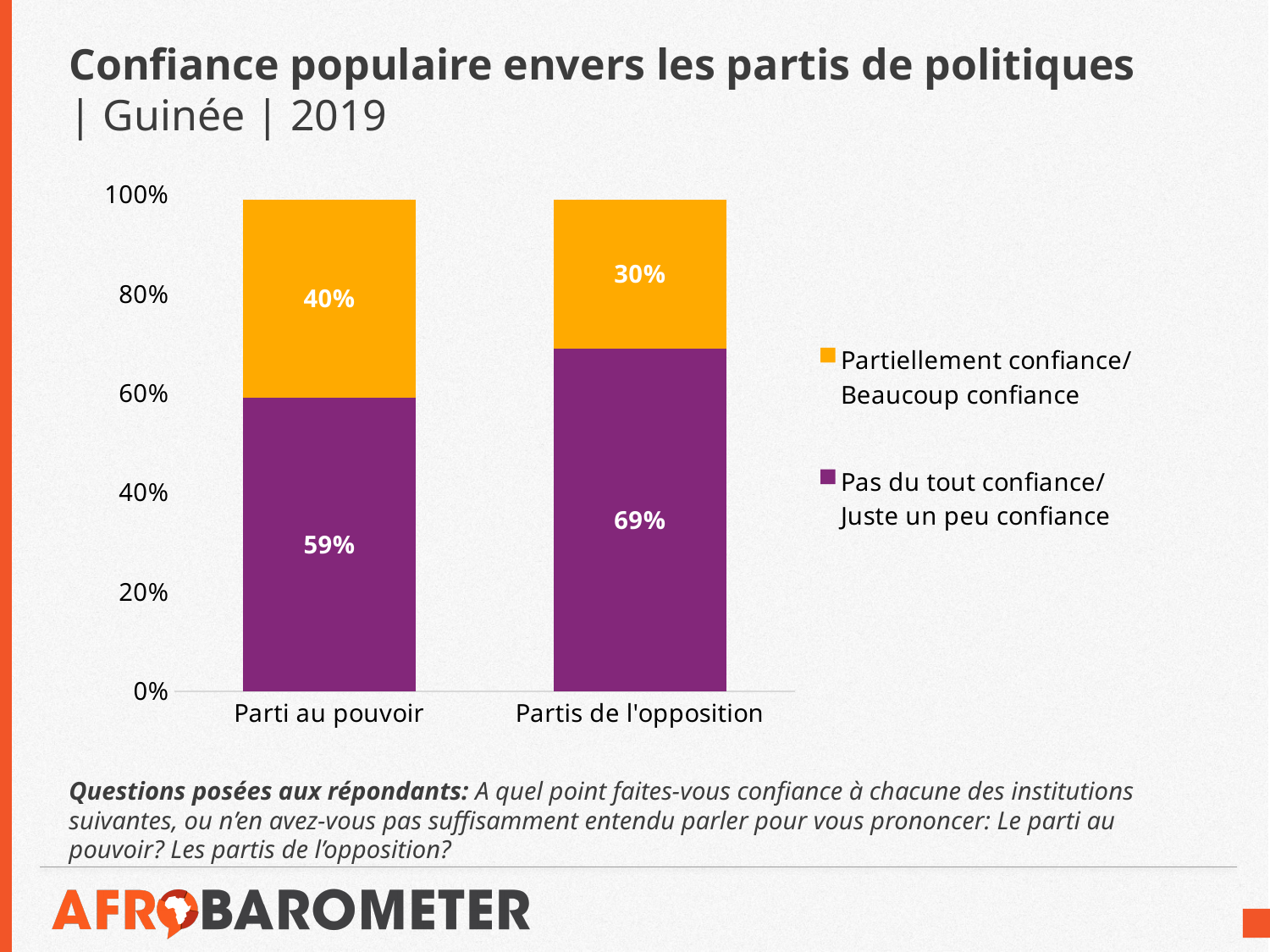
How many categories are shown on the x axis? 2 What is the value for 'Pas du tout confiance/Juste un peu confiance' for the Partis de l'opposition? 69% What is the difference between the 'Pas du tout confiance/Juste un peu confiance' values for Partis de l'opposition and Parti au pouvoir? 10 percentage points What is the total of the stacked bar for the Parti au pouvoir? 99% What kind of chart is shown on the slide? Stacked bar chart Which category has the higher value for 'Pas du tout confiance/Juste un peu confiance'? Partis de l'opposition Which category has the lower value for 'Partiellement confiance/Beaucoup confiance'? Partis de l'opposition What percentage of respondents have 'Partiellement confiance/Beaucoup confiance' in the Partis de l'opposition? 30% How many series does the legend list? 2 What percentage of respondents have 'Pas du tout confiance/Juste un peu confiance' in the Parti au pouvoir? 59% What is the value for 'Partiellement confiance/Beaucoup confiance' for the Parti au pouvoir? 40% Is the 'Partiellement confiance/Beaucoup confiance' value larger for the Parti au pouvoir or the Partis de l'opposition? Parti au pouvoir